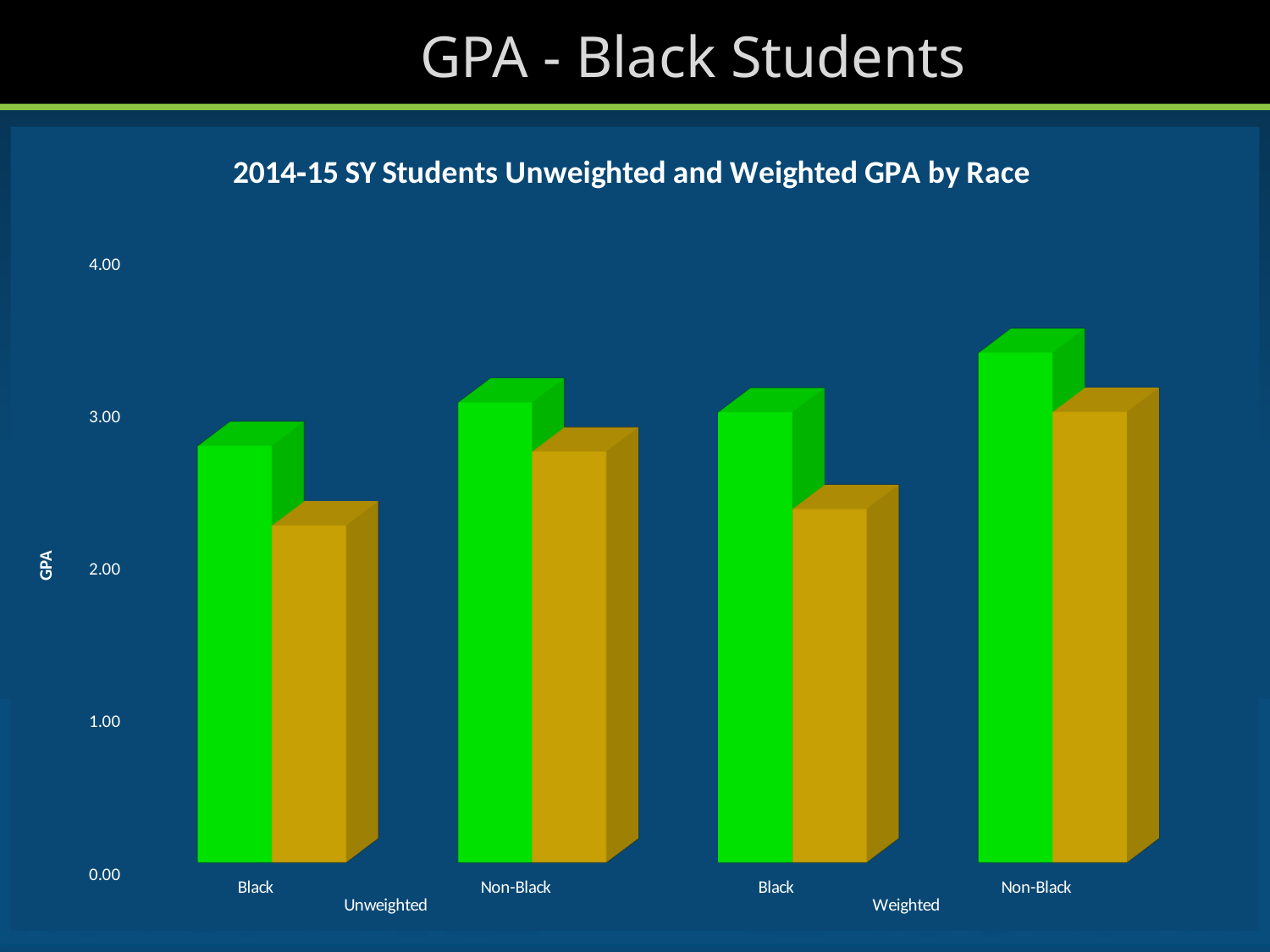
What is the label on the vertical axis of the chart? GPA How many category groups are shown along the x axis of the chart? 4 What kind of chart is shown on the slide? bar chart Is the green bar for Black students in the Unweighted group greater or less than 2.00? greater What is the title of the chart? 2014-15 SY Students Unweighted and Weighted GPA by Race Which is larger: the green bar for Black students in the Unweighted group or the green bar for Non-Black students in the Weighted group? Non-Black (Weighted) Is the green bar for Non-Black students in the Weighted group greater or less than 3.00? greater Is the gold bar for Non-Black students in the Unweighted group greater or less than 2.00? greater Which category has the shortest gold bar? Black (Unweighted) Which category has the tallest green bar? Non-Black (Weighted)